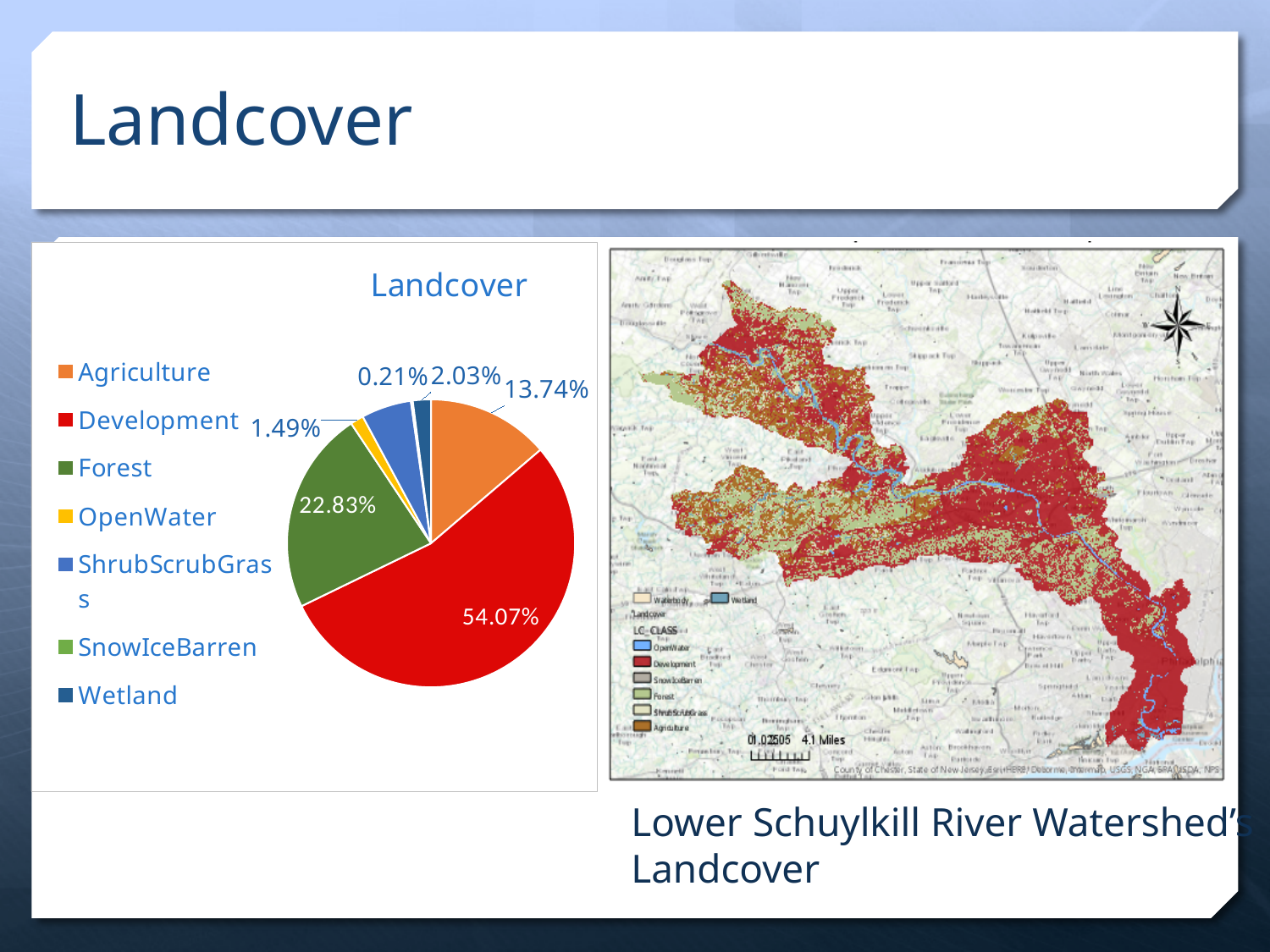
What percentage of the pie is Development? 54.07% What kind of chart is shown on the left of the slide? pie chart What percentage of the pie is Agriculture? 13.74% What is the difference in percentage points between Agriculture and OpenWater? 12.25% Which landcover category has the largest share of the pie? Development Which is larger in the pie chart, Forest or Agriculture? Forest What is the difference in percentage points between Development and Forest? 31.24% What colour is the Development slice in the pie chart? red What percentage of the pie is OpenWater? 1.49% What percentage of the pie is Forest? 22.83% How many landcover categories does the pie chart's legend list? 7 What is the title of the pie chart? Landcover